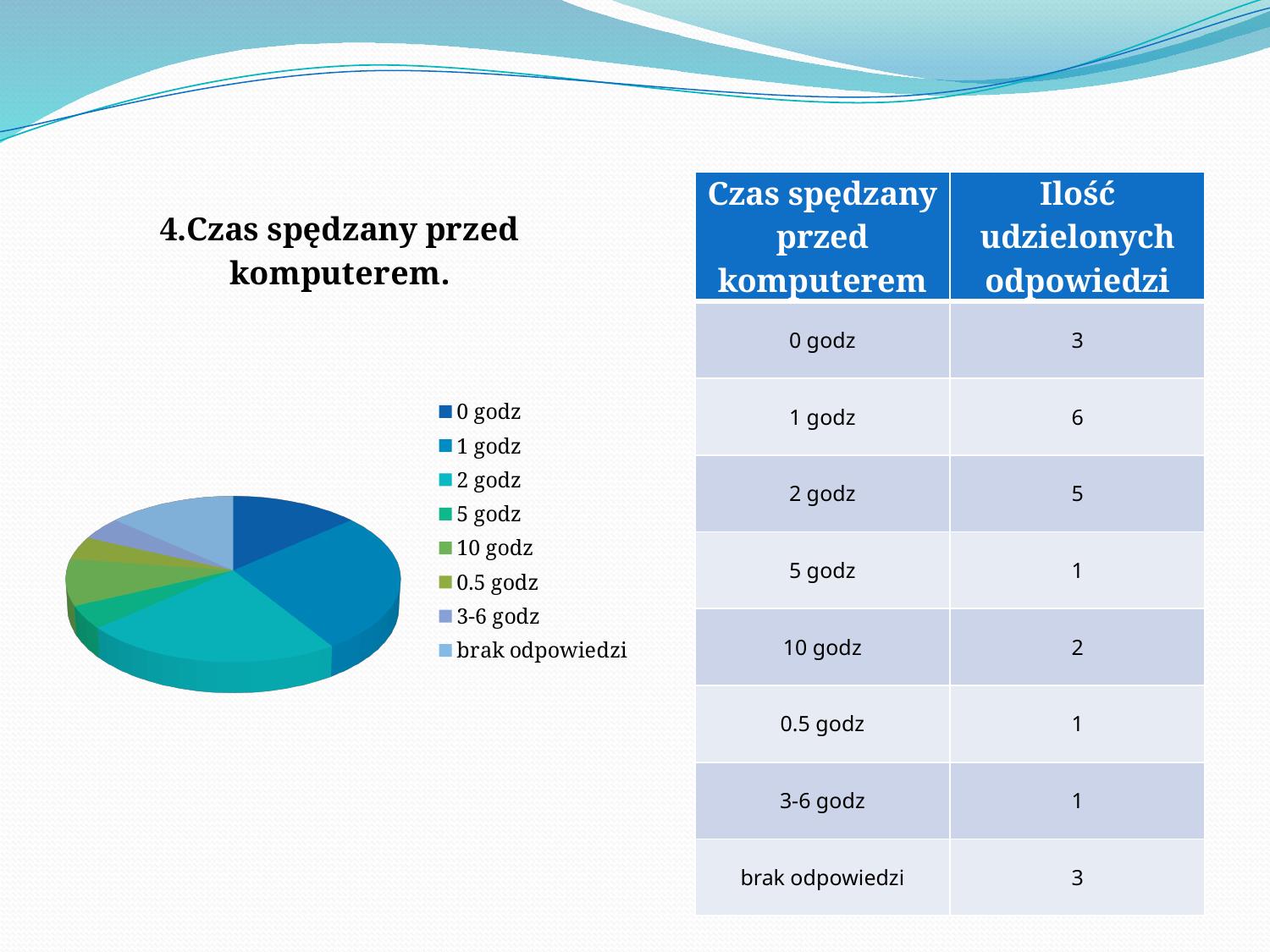
How many responses are recorded for 'brak odpowiedzi'? 3 How many categories does the pie chart's legend list? 8 What is the total number of responses across all categories in the pie chart? 22 How many responses are recorded for the '2 godz' category? 5 What is the title of the chart on the slide? 4.Czas spędzany przed komputerem. How many responses are recorded for the '1 godz' category? 6 Which has more responses, '1 godz' or '2 godz'? 1 godz How many responses are recorded for the '10 godz' category? 2 Which category has the largest slice of the pie? 1 godz What is the difference in responses between '1 godz' and '0 godz'? 3 Which has more responses, '0 godz' or '5 godz'? 0 godz What kind of chart is shown on the slide? pie chart